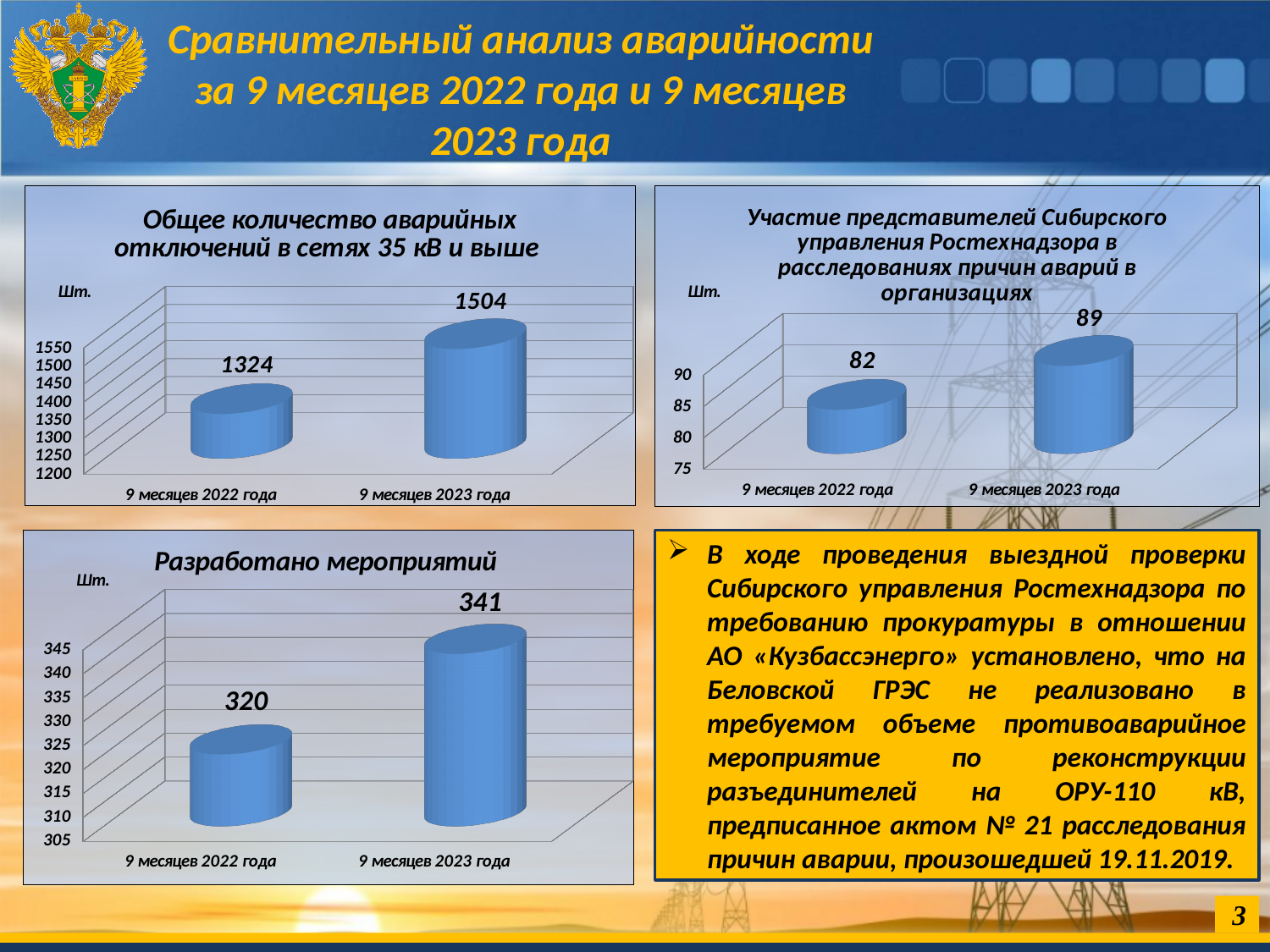
In the chart titled "Участие представителей Сибирского управления Ростехнадзора в расследованиях причин аварий в организациях", what is the value for "9 месяцев 2022 года"? 82 In the chart titled "Общее количество аварийных отключений в сетях 35 кВ и выше", what is the value for "9 месяцев 2023 года"? 1504 In the chart titled "Разработано мероприятий", what is the difference between the two values? 21 In the chart titled "Разработано мероприятий", is the value for "9 месяцев 2022 года" greater or less than 325? less In the chart titled "Разработано мероприятий", which period has the lower value? 9 месяцев 2022 года In the chart titled "Участие представителей Сибирского управления Ростехнадзора в расследованиях причин аварий в организациях", which period has the higher value? 9 месяцев 2023 года In the chart titled "Разработано мероприятий", what is the value for "9 месяцев 2023 года"? 341 In the chart titled "Общее количество аварийных отключений в сетях 35 кВ и выше", what is the value for "9 месяцев 2022 года"? 1324 In the chart titled "Общее количество аварийных отключений в сетях 35 кВ и выше", what is the difference between the 2023 and 2022 values? 180 In the chart titled "Участие представителей Сибирского управления Ростехнадзора в расследованиях причин аварий в организациях", by how much does the 2023 value exceed the 2022 value? 7 What type of chart is the one titled "Разработано мероприятий"? bar chart How many categories are shown in the chart titled "Общее количество аварийных отключений в сетях 35 кВ и выше"? 2